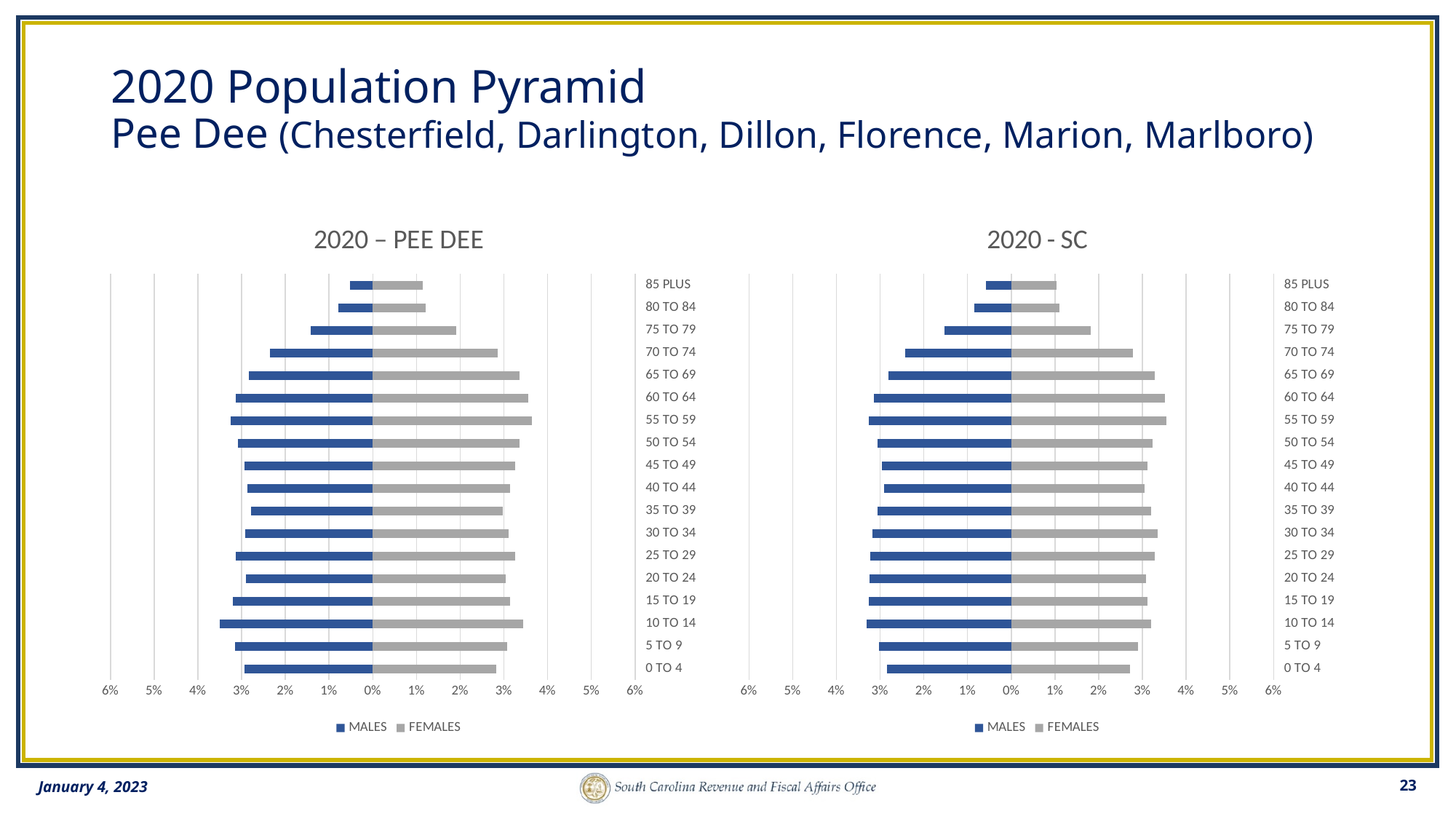
What are the two series named in the legend of the 2020 – PEE DEE chart? MALES and FEMALES In the 2020 - SC chart, for the 70 TO 74 age group, which is larger: MALES or FEMALES? FEMALES In the 2020 – PEE DEE chart, is the MALES value for 10 TO 14 greater or less than 3%? greater How many age groups are shown on the 2020 – PEE DEE chart? 18 In the 2020 - SC chart, is the MALES value for 0 TO 4 greater or less than 3%? less In the 2020 – PEE DEE chart, is the FEMALES value for 55 TO 59 greater or less than 3%? greater In the 2020 – PEE DEE chart, which age group has the highest MALES value? 10 TO 14 In the 2020 – PEE DEE chart, which age group has the lowest MALES value? 85 PLUS What kind of chart is the 2020 – PEE DEE chart? Bar chart How many series does the legend of the 2020 - SC chart list? 2